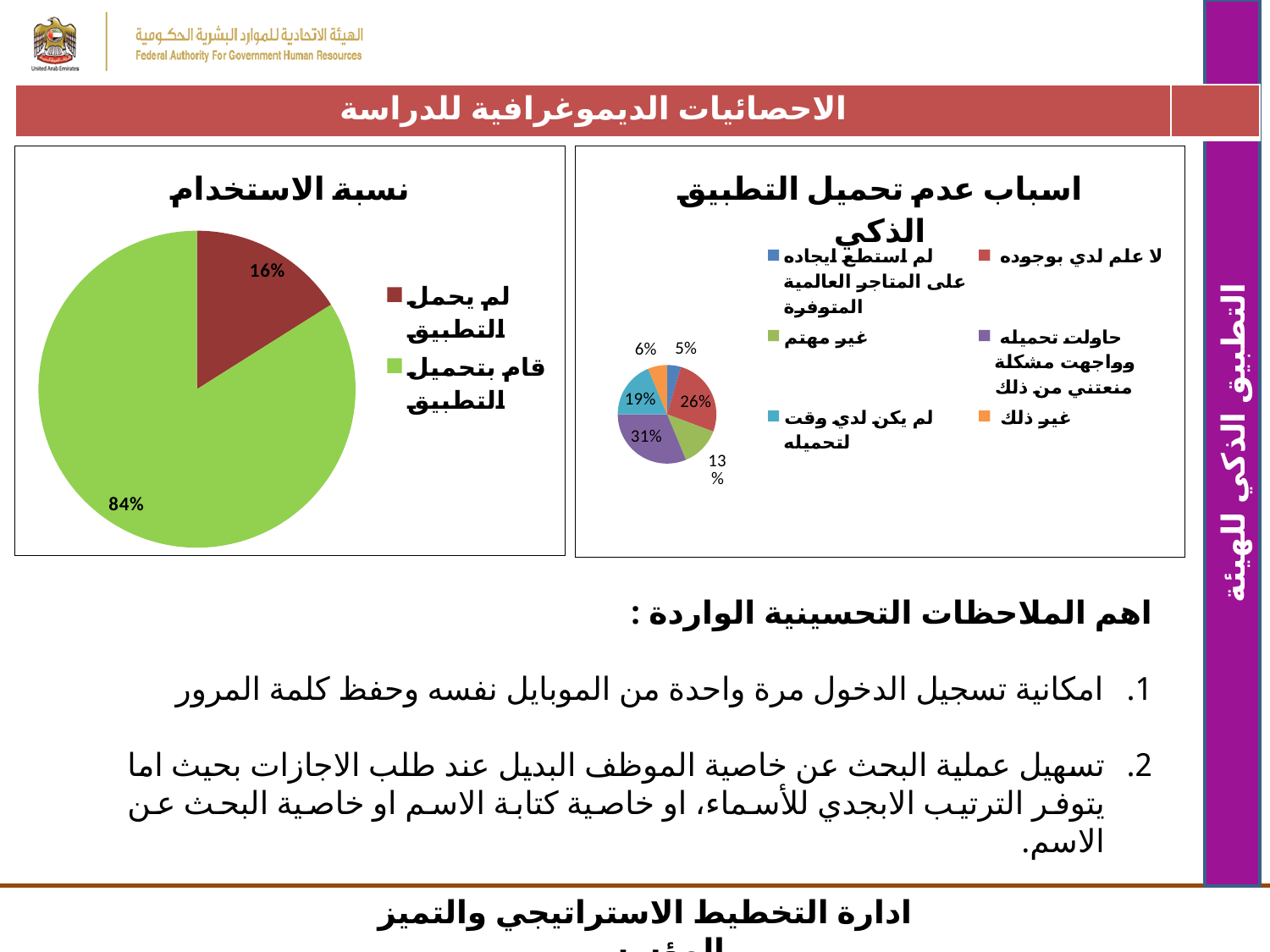
How many categories does the legend of the chart titled اسباب عدم تحميل التطبيق الذكي list? 6 In the chart titled نسبة الاستخدام, what is the difference in percentage points between قام بتحميل التطبيق and لم يحمل التطبيق? 68 In the chart titled اسباب عدم تحميل التطبيق الذكي, which reason has the largest share? حاولت تحميله وواجهت مشكلة منعتني من ذلك In the chart titled اسباب عدم تحميل التطبيق الذكي, what percentage is shown for غير مهتم? 13% In the chart titled اسباب عدم تحميل التطبيق الذكي, which is larger: لم يكن لدي وقت لتحميله or غير ذلك? لم يكن لدي وقت لتحميله What type of chart is the chart titled نسبة الاستخدام? pie chart In the chart titled نسبة الاستخدام, what percentage is shown for لم يحمل التطبيق? 16% In the chart titled اسباب عدم تحميل التطبيق الذكي, what percentage is shown for لا علم لدي بوجوده? 26% In the chart titled اسباب عدم تحميل التطبيق الذكي, what is the smallest percentage shown? 5% How many categories does the legend of the chart titled نسبة الاستخدام list? 2 In the chart titled نسبة الاستخدام, which category has the larger share? قام بتحميل التطبيق In the chart titled نسبة الاستخدام, what percentage is shown for قام بتحميل التطبيق? 84%